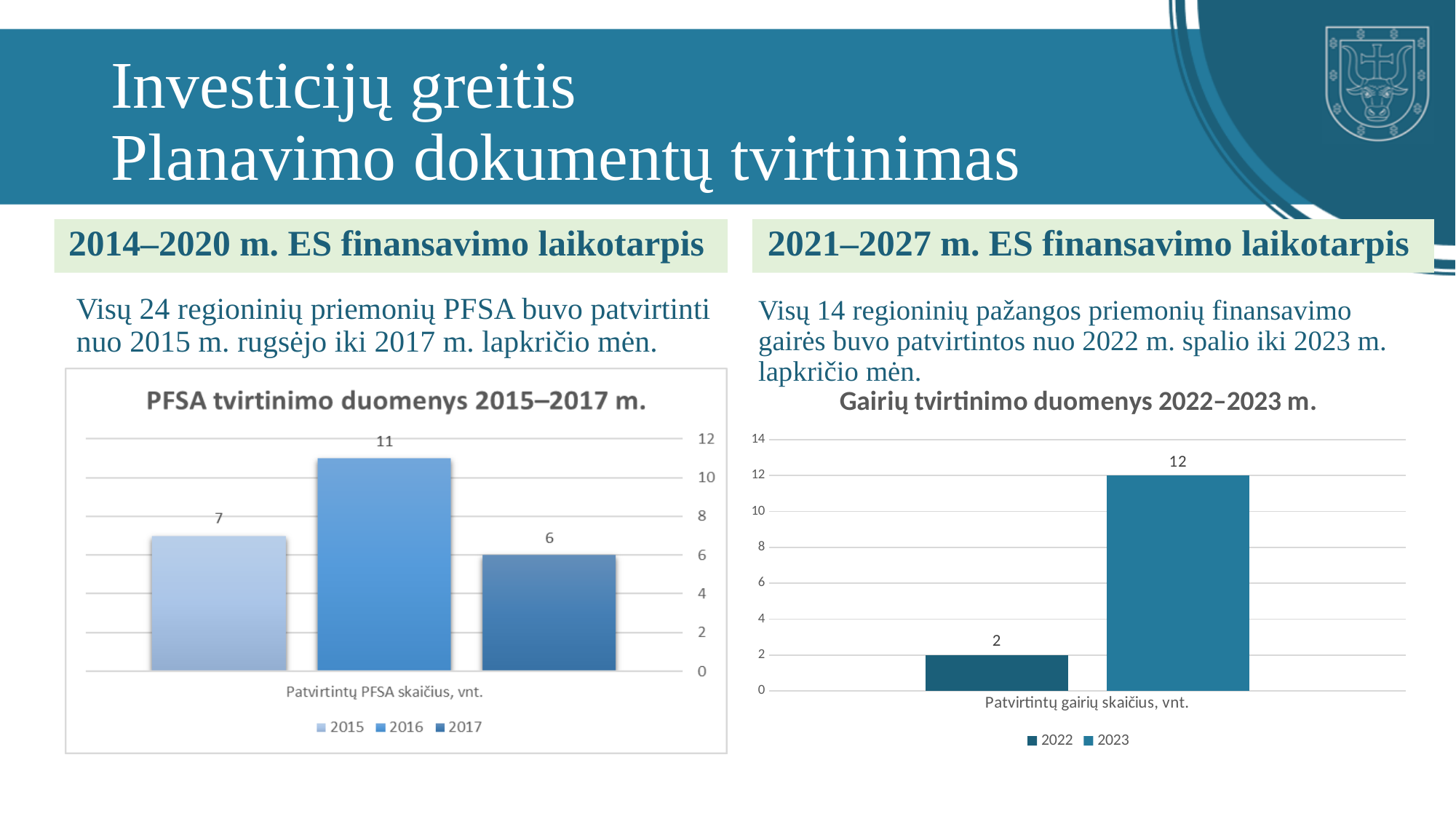
In the chart titled 'PFSA tvirtinimo duomenys 2015–2017 m.', how many series does the legend list? 3 In the chart titled 'Gairių tvirtinimo duomenys 2022–2023 m.', what is the value for 2022? 2 In the chart titled 'Gairių tvirtinimo duomenys 2022–2023 m.', what is the value for 2023? 12 In the chart titled 'PFSA tvirtinimo duomenys 2015–2017 m.', which year has the lowest value? 2017 In the chart titled 'PFSA tvirtinimo duomenys 2015–2017 m.', what is the value for 2015? 7 In the chart titled 'Gairių tvirtinimo duomenys 2022–2023 m.', what is the difference between the values for 2023 and 2022? 10 In the chart titled 'PFSA tvirtinimo duomenys 2015–2017 m.', which year has the highest value? 2016 In the chart titled 'Gairių tvirtinimo duomenys 2022–2023 m.', is the value for 2023 greater or less than 10? greater In the chart titled 'PFSA tvirtinimo duomenys 2015–2017 m.', what is the difference between the values for 2016 and 2017? 5 What kind of chart is the chart titled 'Gairių tvirtinimo duomenys 2022–2023 m.'? bar chart In the chart titled 'PFSA tvirtinimo duomenys 2015–2017 m.', what is the value for 2016? 11 In the chart titled 'Gairių tvirtinimo duomenys 2022–2023 m.', what is the label on the x axis under the bars? Patvirtintų gairių skaičius, vnt.